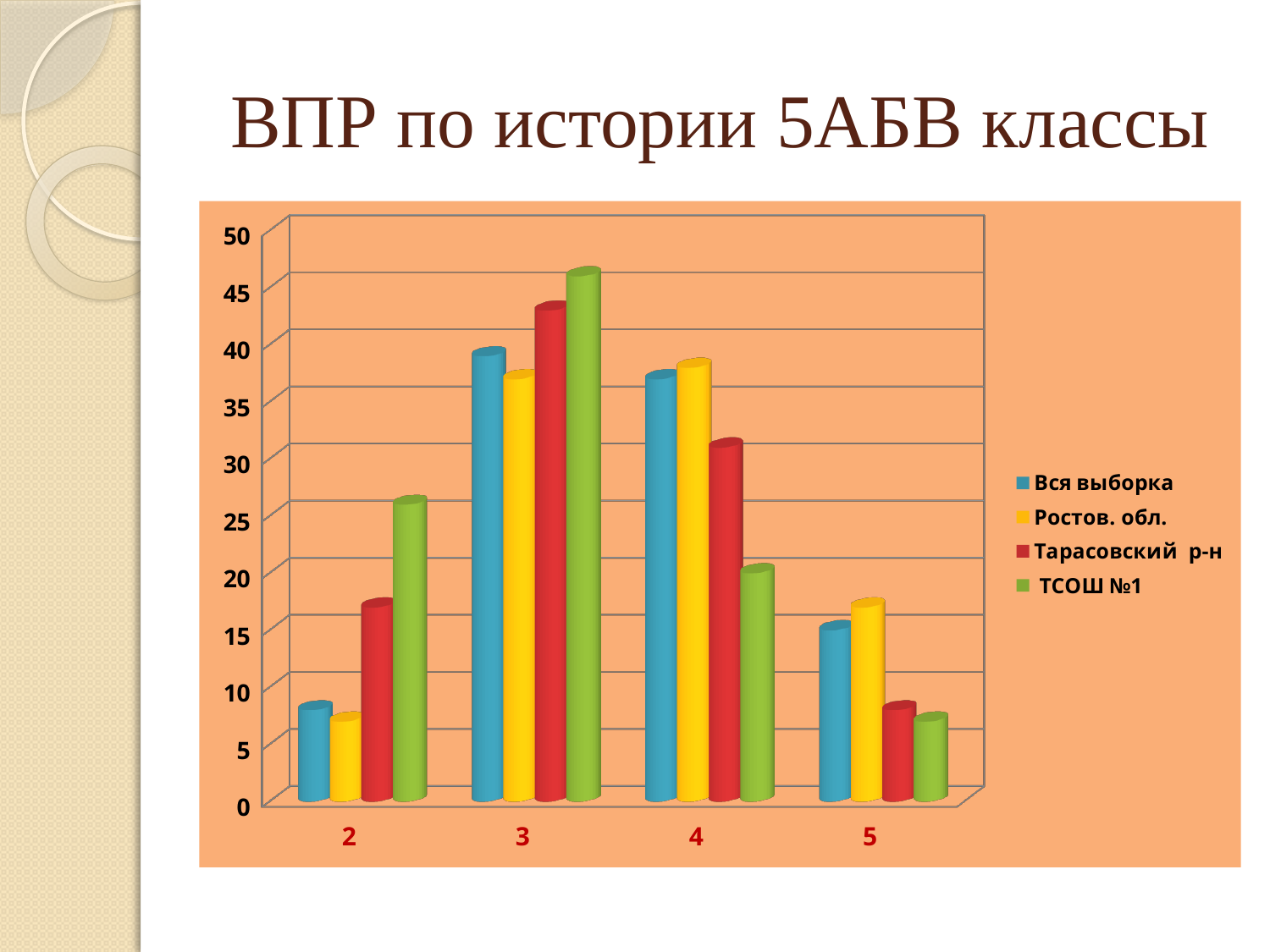
For ТСОШ №1, which category has the lowest value? 5 In category 2, which is larger: Тарасовский р-н or Ростов. обл.? Тарасовский р-н Is the value for Тарасовский р-н in category 4 greater or less than 35? less Is the value for ТСОШ №1 in category 2 greater or less than 20? greater In category 4, which is larger: Вся выборка or ТСОШ №1? Вся выборка In category 3, which series has the highest value? ТСОШ №1 What kind of chart is shown on the slide? bar chart How many series does the legend list? 4 How many categories are shown on the x axis? 4 For ТСОШ №1, which category has the highest value? 3 What is the title of the slide? ВПР по истории 5АБВ классы Which colour represents ТСОШ №1 in the legend? green